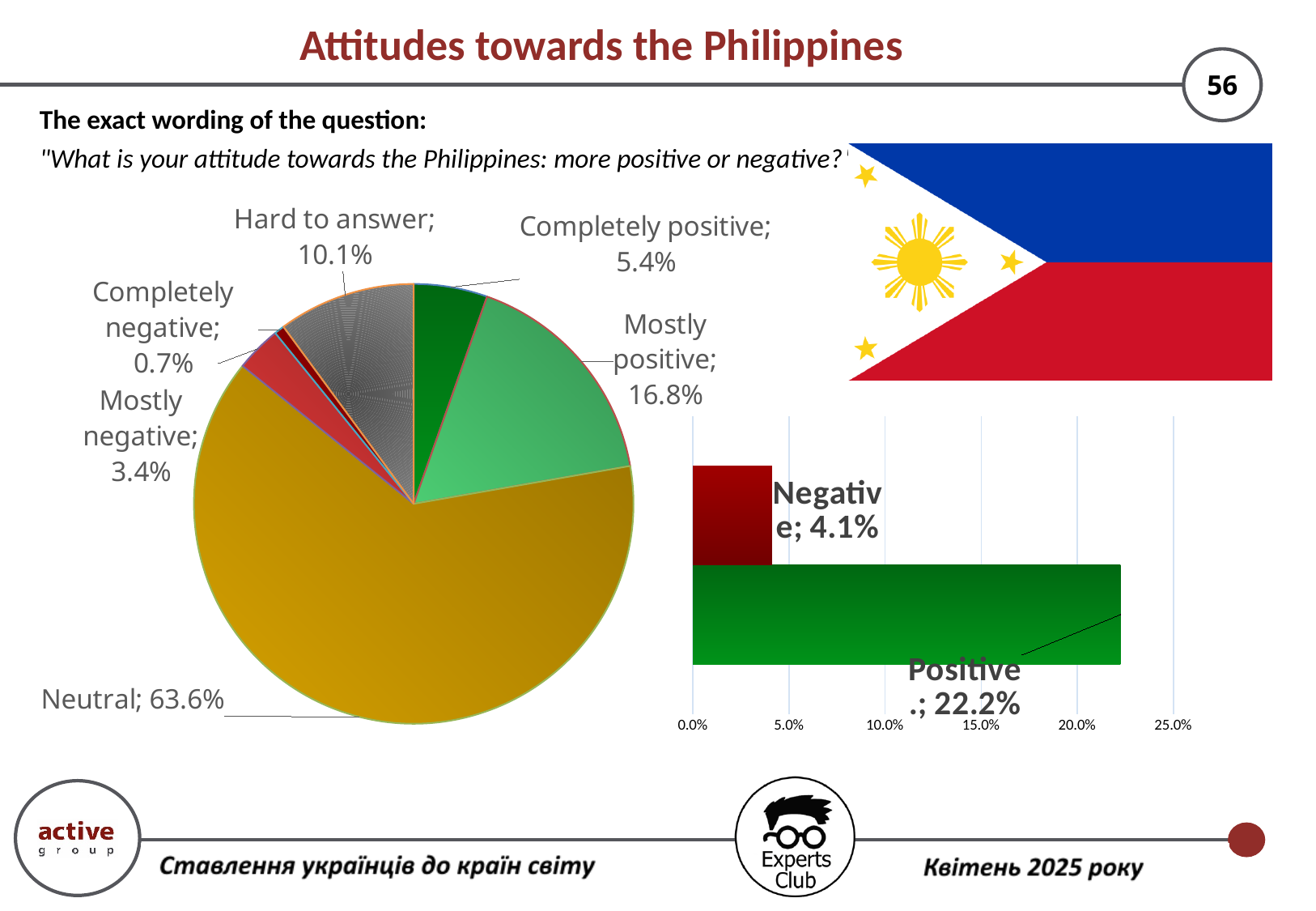
In the pie chart, what is the difference between Mostly positive and Completely positive? 11.4% In the pie chart, which category has the smallest share? Completely negative What kind of chart is shown on the right side of the slide? Bar chart In the pie chart, which is larger: Mostly negative or Hard to answer? Hard to answer In the bar chart on the right, what is the difference between Positive and Negative? 18.1% In the pie chart, which category has the largest share? Neutral In the bar chart on the right, what is the value for Positive? 22.2% How many categories does the pie chart show? 6 In the bar chart on the right, what is the value for Negative? 4.1% In the pie chart, what is the value for Mostly positive? 16.8% In the pie chart, what is the value for Hard to answer? 10.1% In the pie chart, what share of respondents answered Neutral? 63.6%